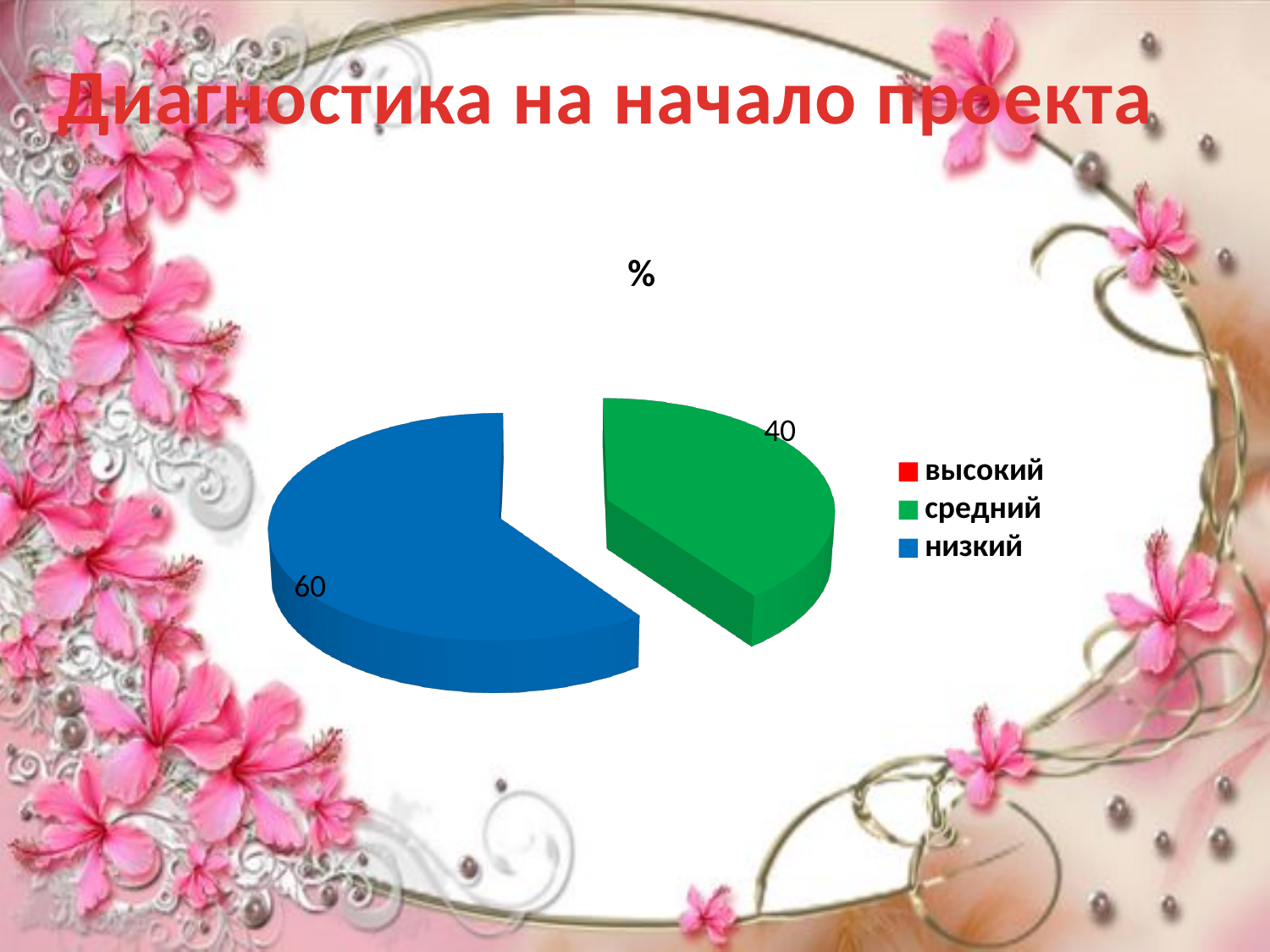
Which category has the largest slice in the pie chart? низкий What is the value shown for the низкий slice of the pie chart? 60 Is the value for низкий in the pie chart greater or less than 50? greater Which is larger in the pie chart, средний or низкий? низкий What is the difference between the низкий and средний values in the pie chart? 20 What colour represents низкий in the pie chart? blue What is the title of the pie chart? % What kind of chart is shown on the slide? pie chart How many slices are visible in the pie chart? 2 How many entries does the legend of the pie chart list? 3 What is the value shown for the средний slice of the pie chart? 40